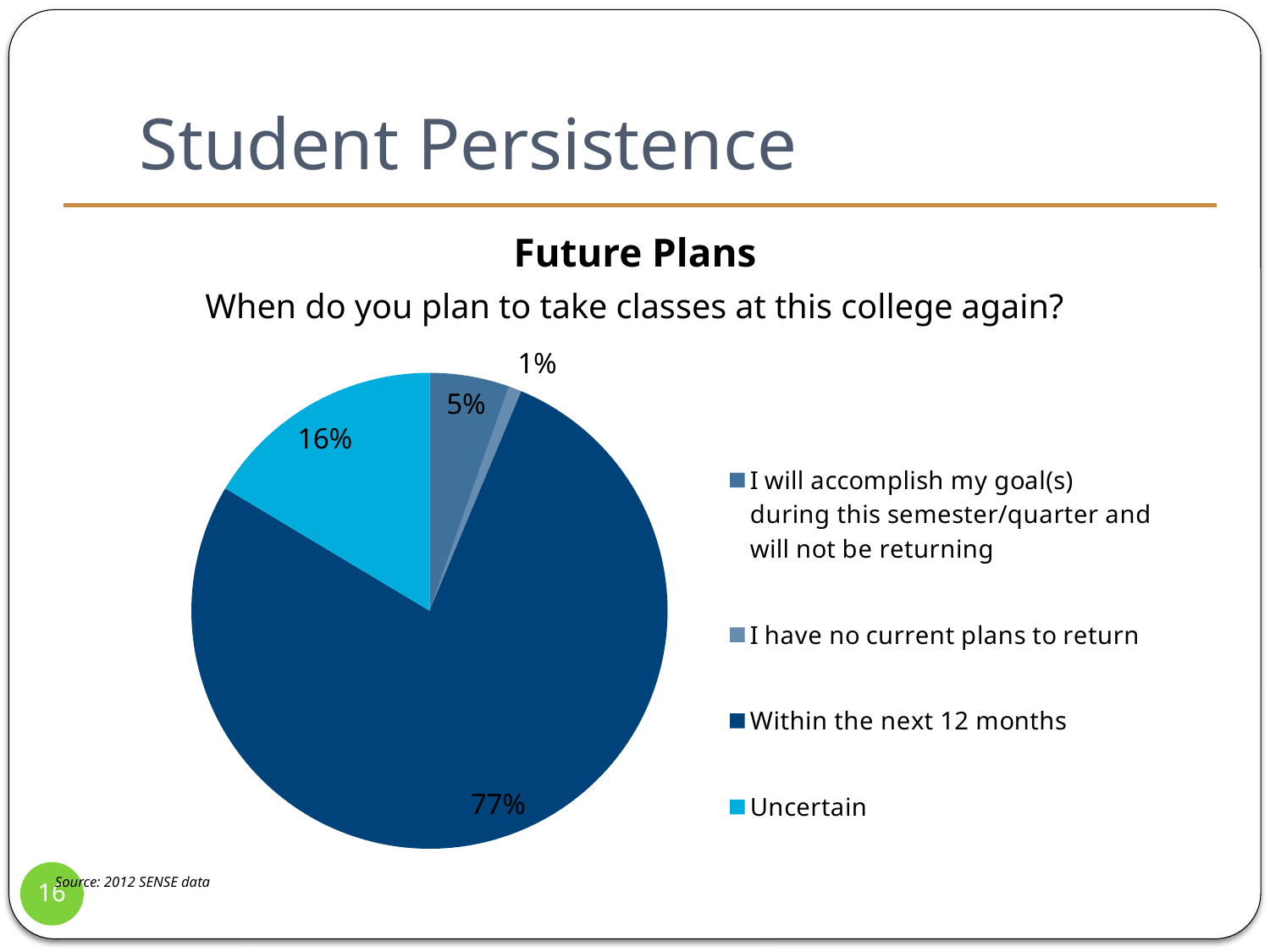
What share of respondents plan to take classes again within the next 12 months? 77% What percentage of respondents are uncertain about when they will take classes again? 16% How many slices does the pie chart have? 4 What is the title of the chart? Future Plans What is the difference in percentage points between 'Within the next 12 months' and 'Uncertain'? 61 What percentage of respondents said they will accomplish their goal(s) during this semester/quarter and will not be returning? 5% What percentage of respondents have no current plans to return? 1% Which is larger: the share for 'Uncertain' or the share for 'I will accomplish my goal(s) during this semester/quarter and will not be returning'? Uncertain How many entries does the legend list? 4 Which response has the smallest share of the pie? I have no current plans to return Which response has the largest share of the pie? Within the next 12 months What kind of chart is shown on the slide? pie chart